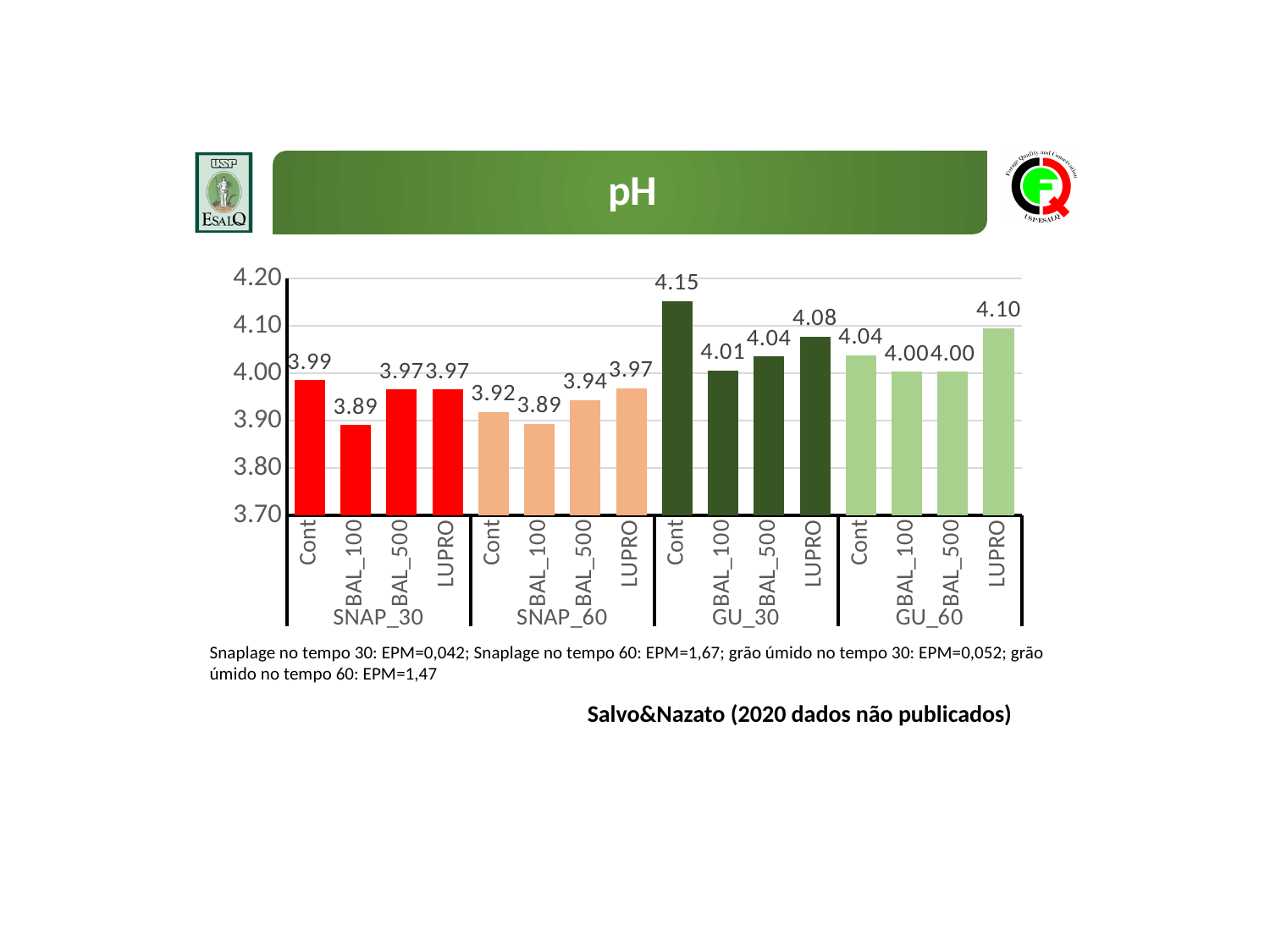
Within the GU_30 group, which treatment has the lowest pH? BAL_100 (4.01) What is the pH value for BAL_500 in the SNAP_60 group? 3.94 Is the pH value for Cont in SNAP_60 greater or less than 4.00? less Which bar has the highest pH value on the chart? Cont in GU_30 (4.15) What is the difference in pH between Cont in GU_30 and Cont in SNAP_30? 0.16 How many bars are plotted on the chart? 16 What is the pH value for BAL_100 in the SNAP_30 group? 3.89 What is the pH value for LUPRO in the GU_60 group? 4.10 Which is larger: the pH for LUPRO in GU_30 or the pH for LUPRO in GU_60? LUPRO in GU_60 (4.10) What is the title of the chart? pH What type of chart is shown on the slide? Bar chart What is the pH value for Cont in the GU_30 group? 4.15